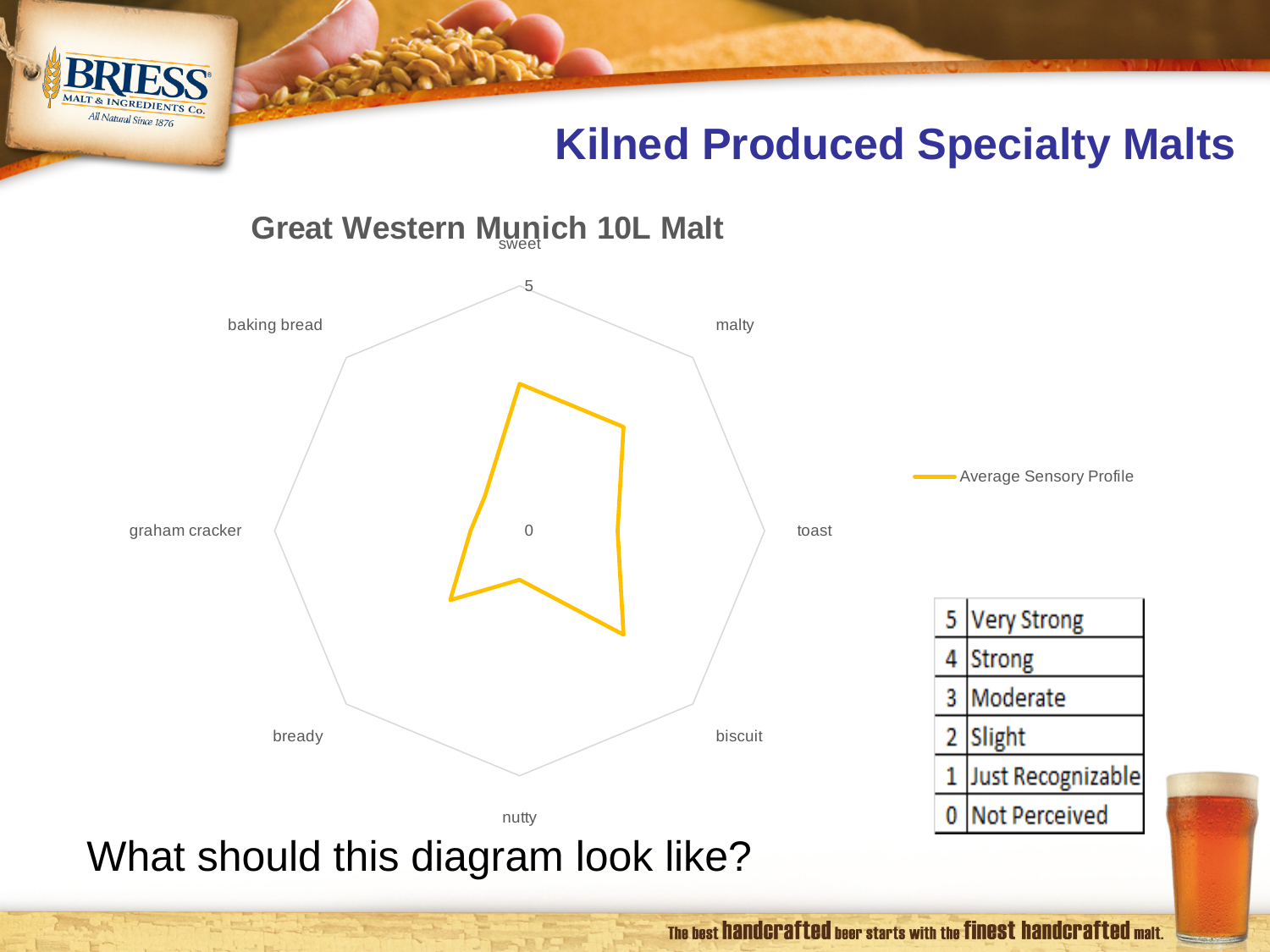
On the Great Western Munich 10L Malt chart, which has the larger value, malty or nutty? malty On the Great Western Munich 10L Malt chart, which has the larger value, sweet or nutty? sweet How many series does the legend of the Great Western Munich 10L Malt chart list? 1 What is the title of the radar chart on the slide? Great Western Munich 10L Malt Is the value for sweet on the Great Western Munich 10L Malt chart greater or less than 5? less What is the name of the series shown in the legend of the radar chart? Average Sensory Profile Is the value for malty on the Great Western Munich 10L Malt chart greater or less than 5? less How many sensory attributes (axes) are plotted on the Great Western Munich 10L Malt chart? 8 What kind of chart is used to show the Great Western Munich 10L Malt sensory profile? radar chart On the Great Western Munich 10L Malt chart, which has the larger value, biscuit or graham cracker? biscuit Is the value for nutty on the Great Western Munich 10L Malt chart greater or less than 5? less